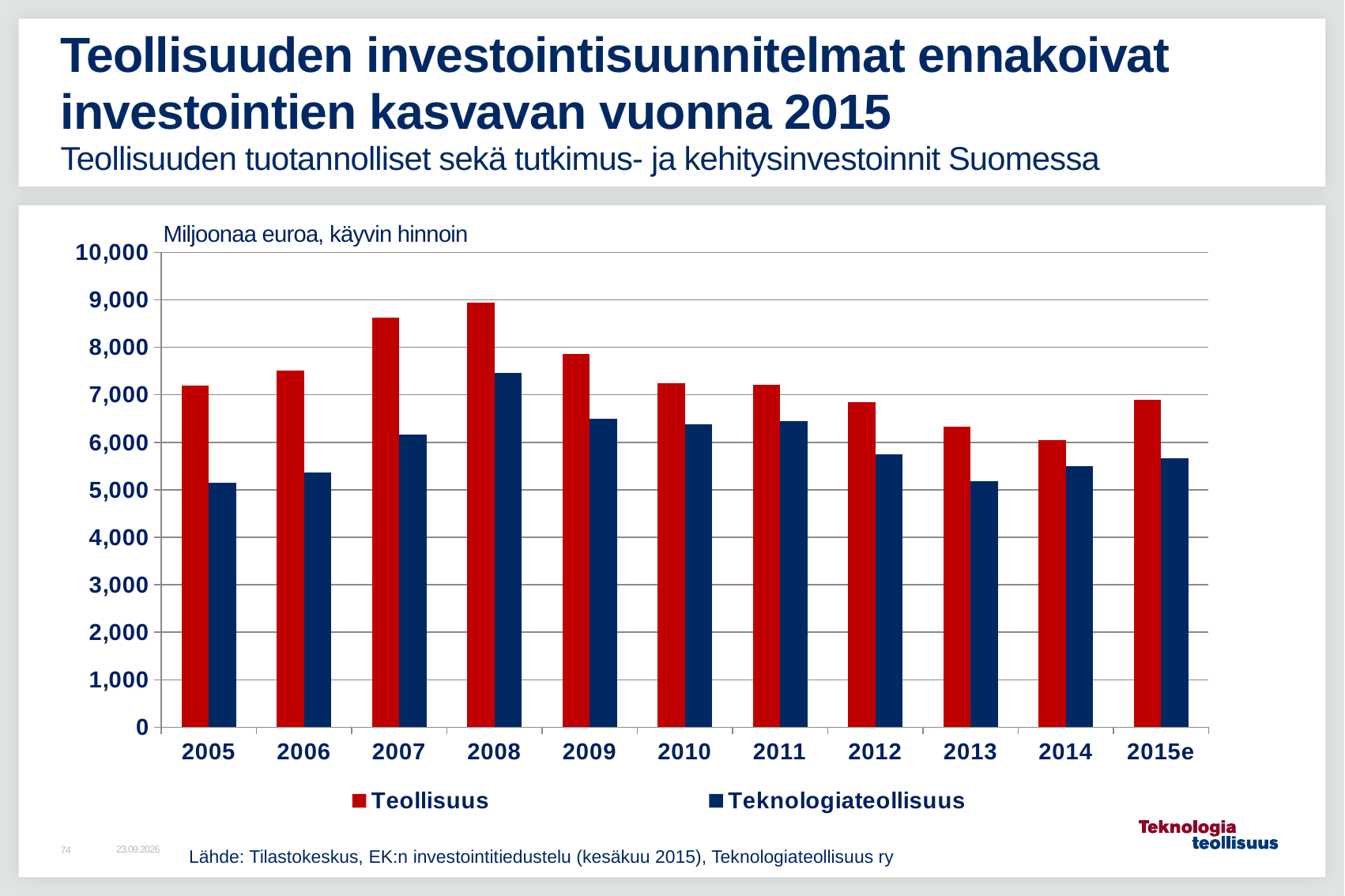
Is the Teollisuus value for 2008 greater or less than 8,000? greater In 2007, which series has the larger value, Teollisuus or Teknologiateollisuus? Teollisuus In which year is the Teollisuus value lowest? 2014 What kind of chart is shown on the slide? bar chart Do the Teollisuus values rise or fall from 2008 to 2014? fall Is the Teollisuus value for 2013 greater or less than 6,000? greater How many series does the legend list? 2 In which year is the Teknologiateollisuus value highest? 2008 In which year is the Teollisuus value highest? 2008 What unit is stated above the chart? Miljoonaa euroa, käyvin hinnoin Is the Teknologiateollisuus value for 2012 greater or less than 6,000? less How many years are shown on the x axis? 11